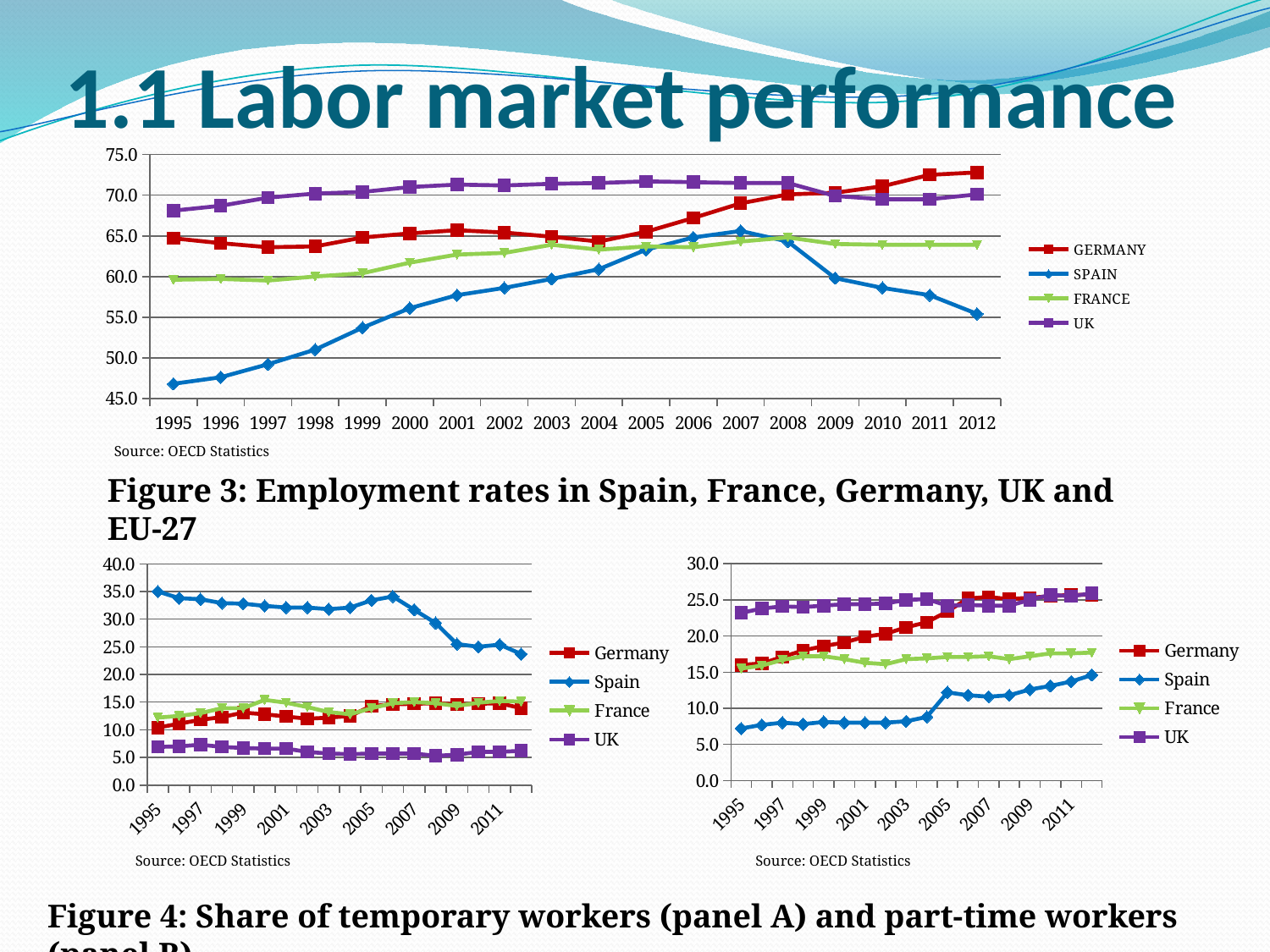
In the top chart (Figure 3, employment rates), how many series does the legend list? 4 In the top chart (Figure 3, employment rates), is the value for UK in 2005 greater or less than 70? greater In the bottom-left chart (Figure 4 panel A, temporary workers), does the value for Spain rise or fall from 2006 to 2012? fall In the top chart (Figure 3, employment rates), which country has the lowest employment rate in 1995? SPAIN In the top chart (Figure 3, employment rates), which country has the highest employment rate in 2012? GERMANY In the bottom-right chart (Figure 4 panel B, part-time workers), is the value for Spain in 1995 greater or less than 10? less What kind of chart is the top chart (Figure 3, employment rates)? line chart In the bottom-left chart (Figure 4 panel A, temporary workers), which country has the highest share in 1995? Spain In the top chart (Figure 3, employment rates), which is larger in 2009: the value for SPAIN or the value for FRANCE? FRANCE In the top chart (Figure 3, employment rates), is the value for SPAIN in 1995 greater or less than 50? less In the bottom-right chart (Figure 4 panel B, part-time workers), does the value for Germany rise or fall from 1995 to 2007? rise In the top chart (Figure 3, employment rates), how many years are shown on the x axis? 18